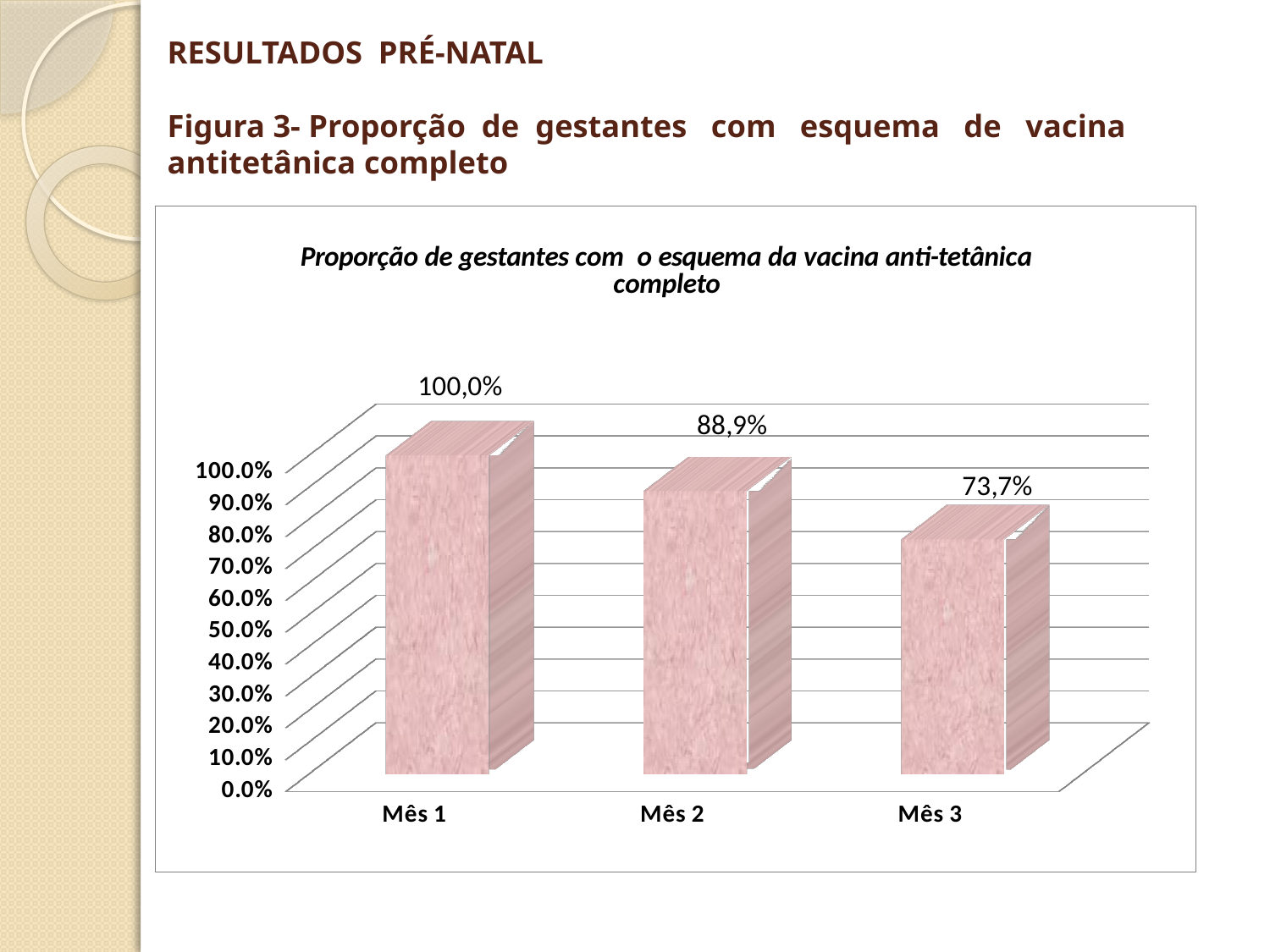
Which month has the highest proportion? Mês 1 What kind of chart is shown? bar chart What is the difference between the values for Mês 2 and Mês 3? 15,2% Is the value for Mês 3 greater or less than 80.0%? less How many months are shown on the x axis? 3 Which month has the lowest proportion? Mês 3 Which is larger, the value for Mês 2 or the value for Mês 3? Mês 2 What is the value for Mês 2? 88,9% What is the value for Mês 1? 100,0% What is the value for Mês 3? 73,7% Do the values rise or fall from Mês 1 to Mês 3? fall What is the difference between the values for Mês 1 and Mês 2? 11,1%